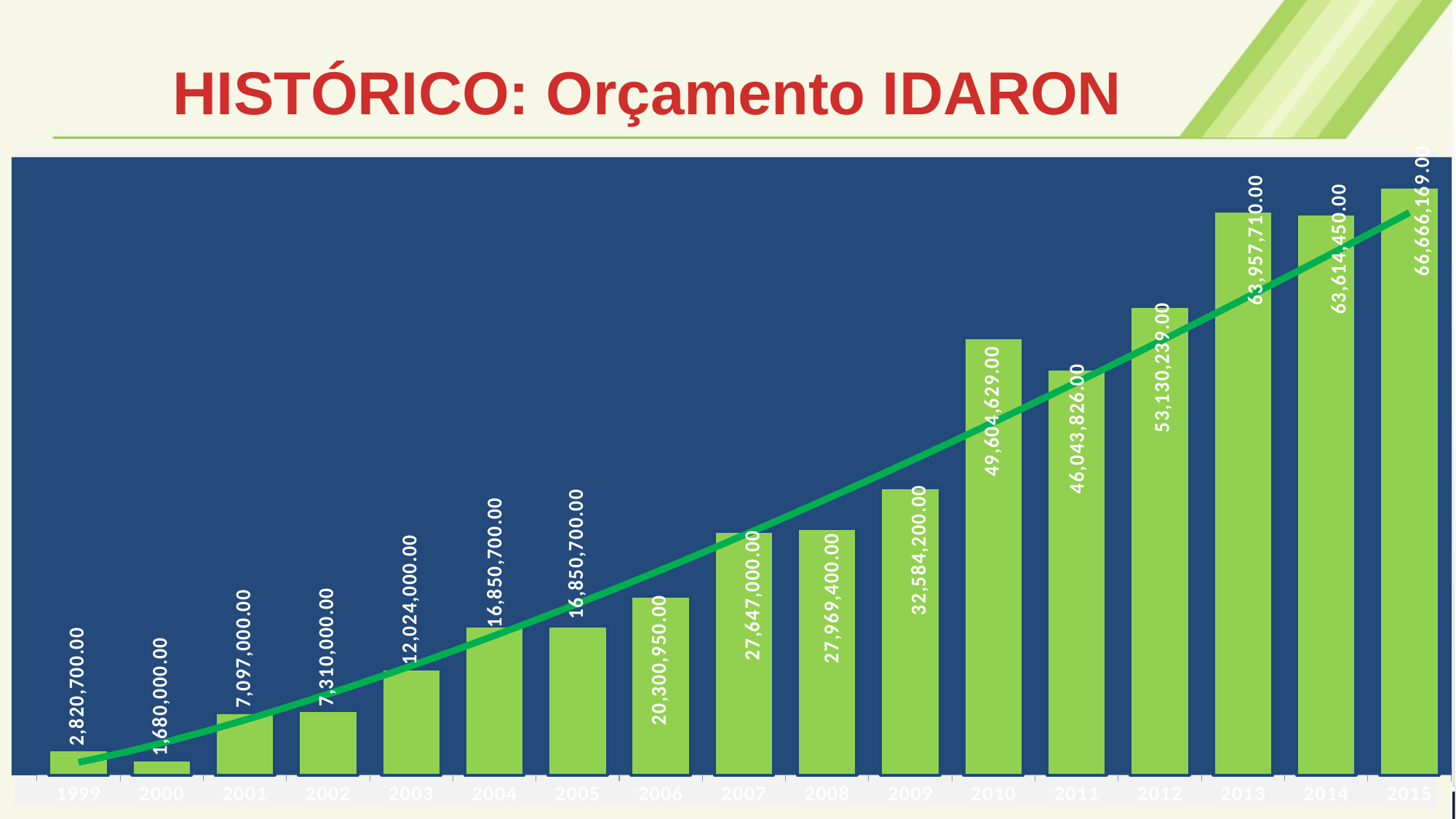
Which year has the lowest value? 2000 Which is larger, the value for 2013 or the value for 2014? 2013 What kind of chart is this? Bar chart Which year has the highest value? 2015 What is the value for 2012? 53,130,239.00 What is the difference between the values for 2010 and 2011? 3,560,803.00 What is the value for 2009? 32,584,200.00 What is the value for 2015? 66,666,169.00 How many years are shown on the x axis? 17 What is the value for 2000? 1,680,000.00 What is the difference between the values for 2015 and 2014? 3,051,719.00 What is the title of the slide? HISTÓRICO: Orçamento IDARON